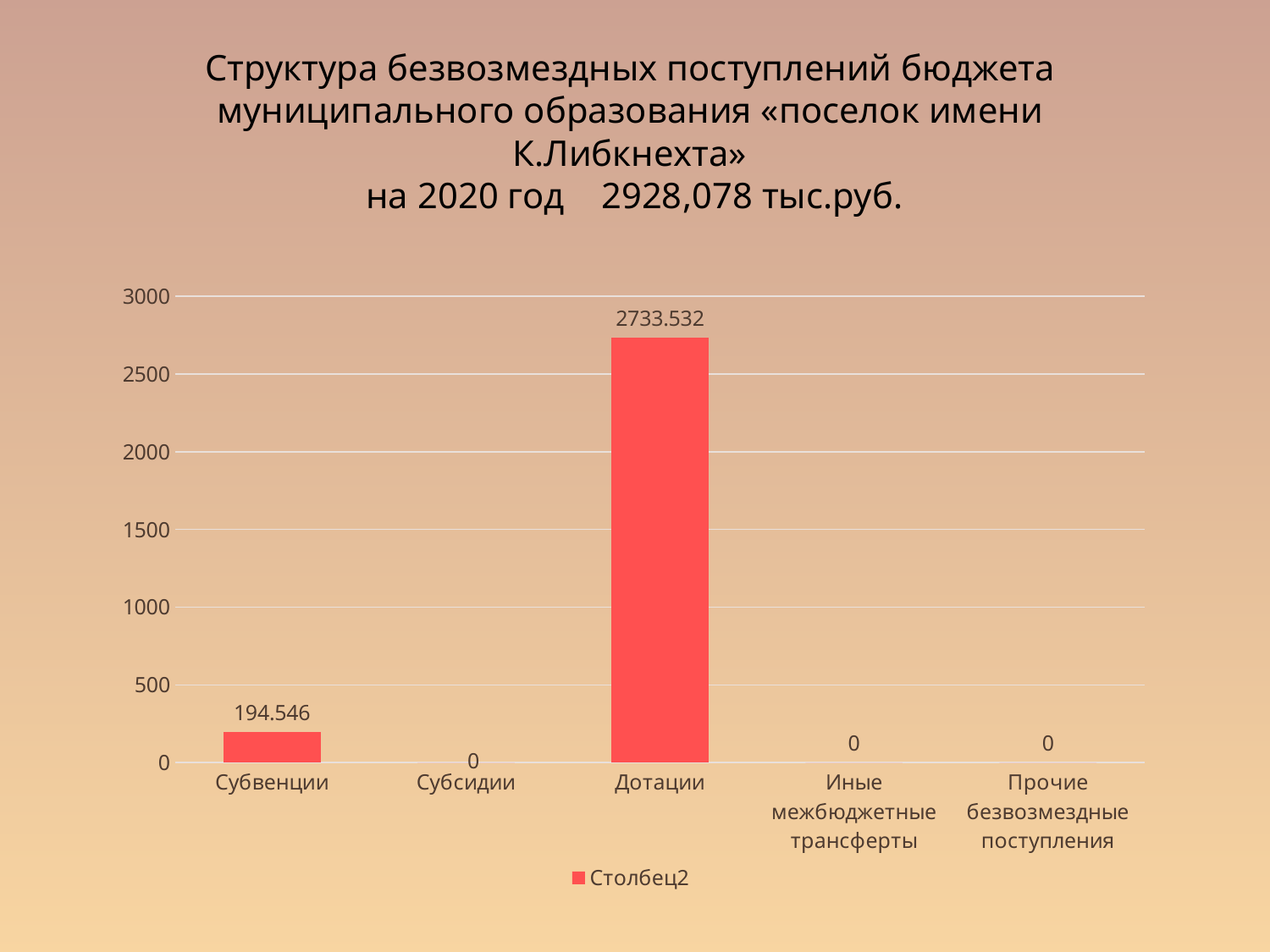
Which category has the highest value? Дотации How many categories are shown on the x axis? 5 What is the value for Субсидии? 0 What is the value for Иные межбюджетные трансферты? 0 Is the value for Субвенции greater or less than 500? less What is the difference between the values for Дотации and Субвенции? 2538.986 What series name does the legend show? Столбец2 What kind of chart is shown on the slide? bar chart What is the value for Дотации? 2733.532 Is the value for Дотации greater or less than 2500? greater Which is larger, the value for Субвенции or the value for Дотации? Дотации What is the value for Субвенции? 194.546